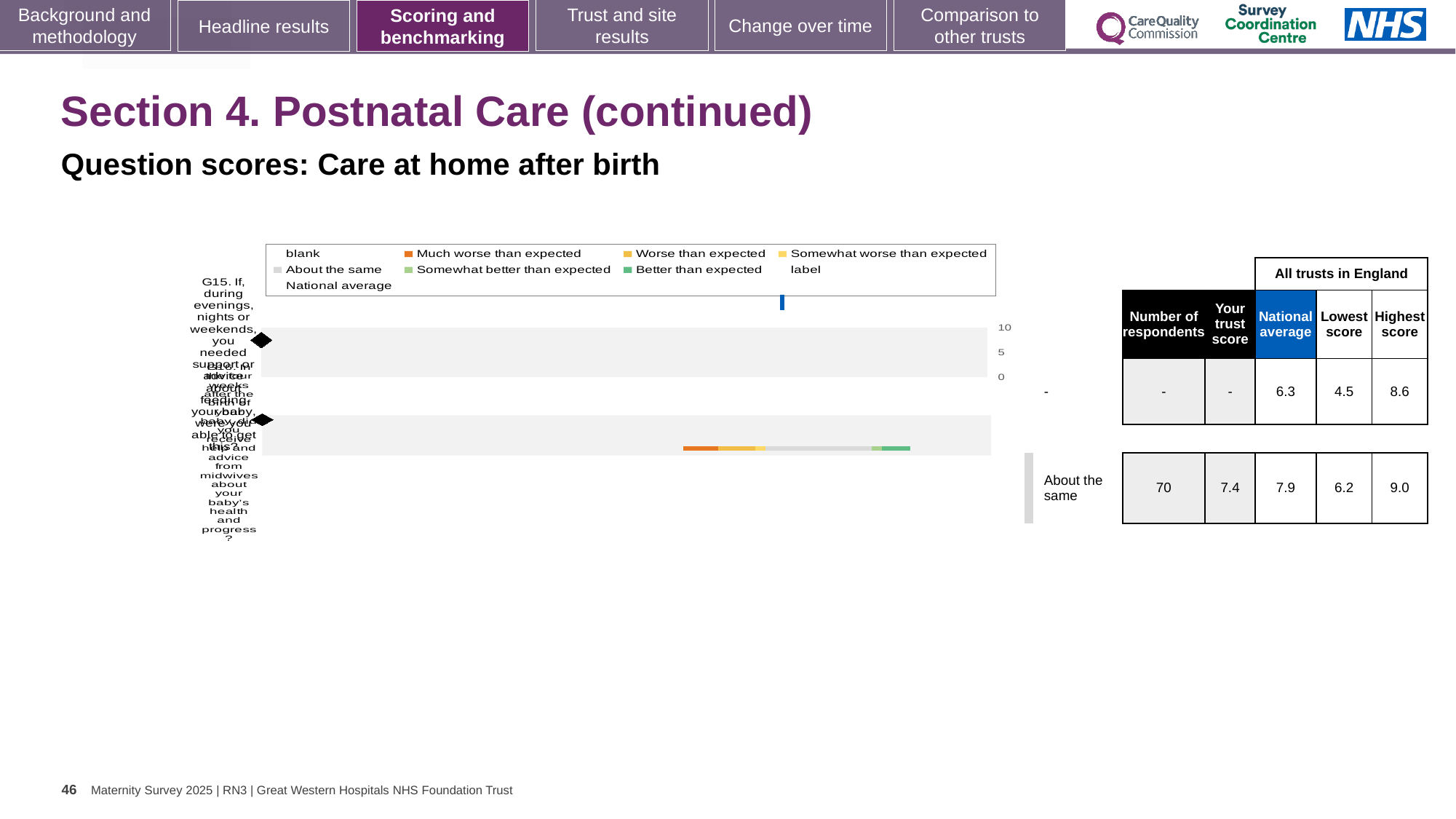
For the row labelled "About the same", which is larger: the trust score or the national average? national average What is the highest tick value shown on the chart's score axis? 10 In the table beside the chart, what is the lowest score for the first (top) row? 4.5 In the table beside the chart, what is the national average for the row labelled "About the same"? 7.9 What colour does the legend use for "Much worse than expected"? orange For the row labelled "About the same", what is the difference between the national average and the trust score? 0.5 In the table beside the chart, what is the national average for the first (top) row? 6.3 In the table beside the chart, what is the highest score for the row labelled "About the same"? 9.0 What kind of chart is shown on the slide? bar chart In the table beside the chart, what is the trust score for the row labelled "About the same"? 7.4 In the table beside the chart, what is the number of respondents for the row labelled "About the same"? 70 What colour does the legend use for "Better than expected"? green